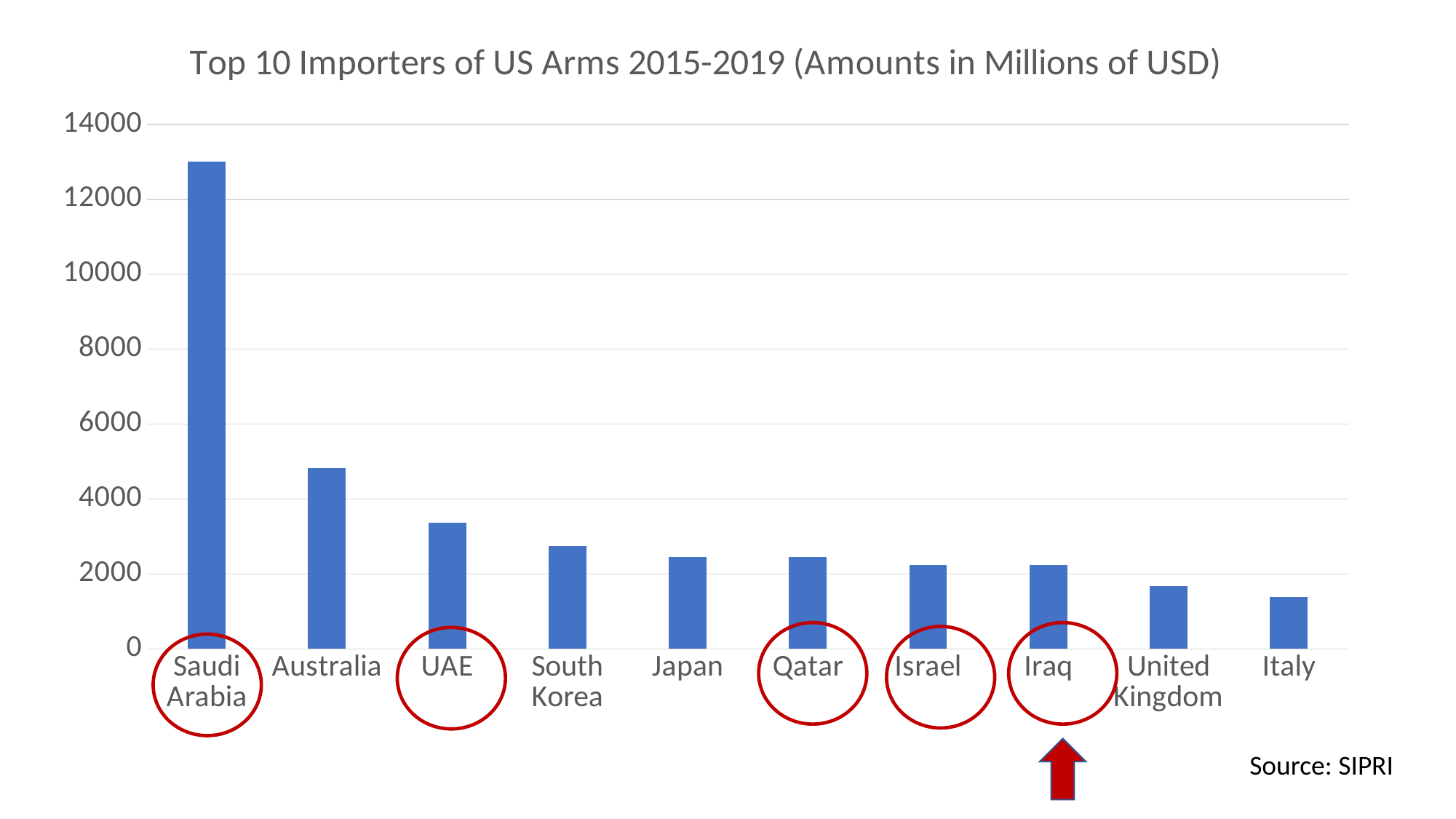
Do the values generally rise or fall moving from left to right along the x axis? Fall Is the value for Italy greater or less than 2000? less Which has a larger value, Australia or UAE? Australia Is the value for UAE greater or less than 4000? less Is the value for Saudi Arabia greater or less than 12000? greater What kind of chart is shown on the slide? Bar chart Which has a larger value, United Kingdom or Italy? United Kingdom Which country has the highest value in the chart? Saudi Arabia How many countries are shown on the x axis of the chart? 10 What is the title of the chart? Top 10 Importers of US Arms 2015-2019 (Amounts in Millions of USD) Which country has the lowest value in the chart? Italy